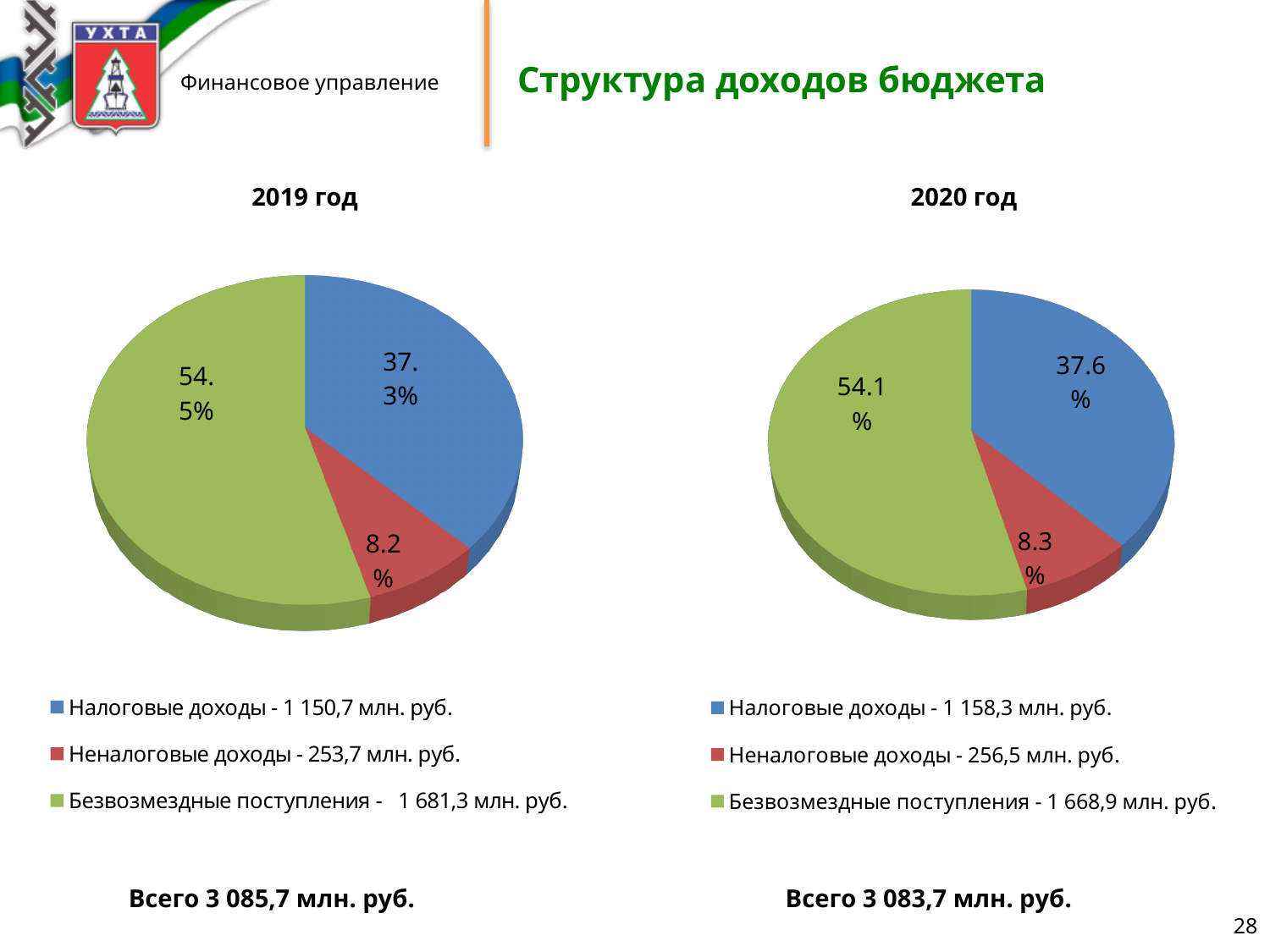
In the 2020 год chart, what colour is the Безвозмездные поступления slice? green In the 2019 год chart, what share of the pie is Безвозмездные поступления? 54.5% In the 2020 год chart, which category has the smallest slice? Неналоговые доходы In the 2019 год chart, which category has the largest slice? Безвозмездные поступления How many slices does the 2020 год pie chart have? 3 In the 2019 год chart, what share of the pie is Неналоговые доходы? 8.2% What kind of chart is used for the 2019 год chart? pie chart In the 2019 год chart, what is the difference in percentage points between the Безвозмездные поступления slice and the Налоговые доходы slice? 17.2 In the 2020 год chart, which is larger: the Налоговые доходы slice or the Неналоговые доходы slice? Налоговые доходы In the 2020 год chart, what share of the pie is Налоговые доходы? 37.6%